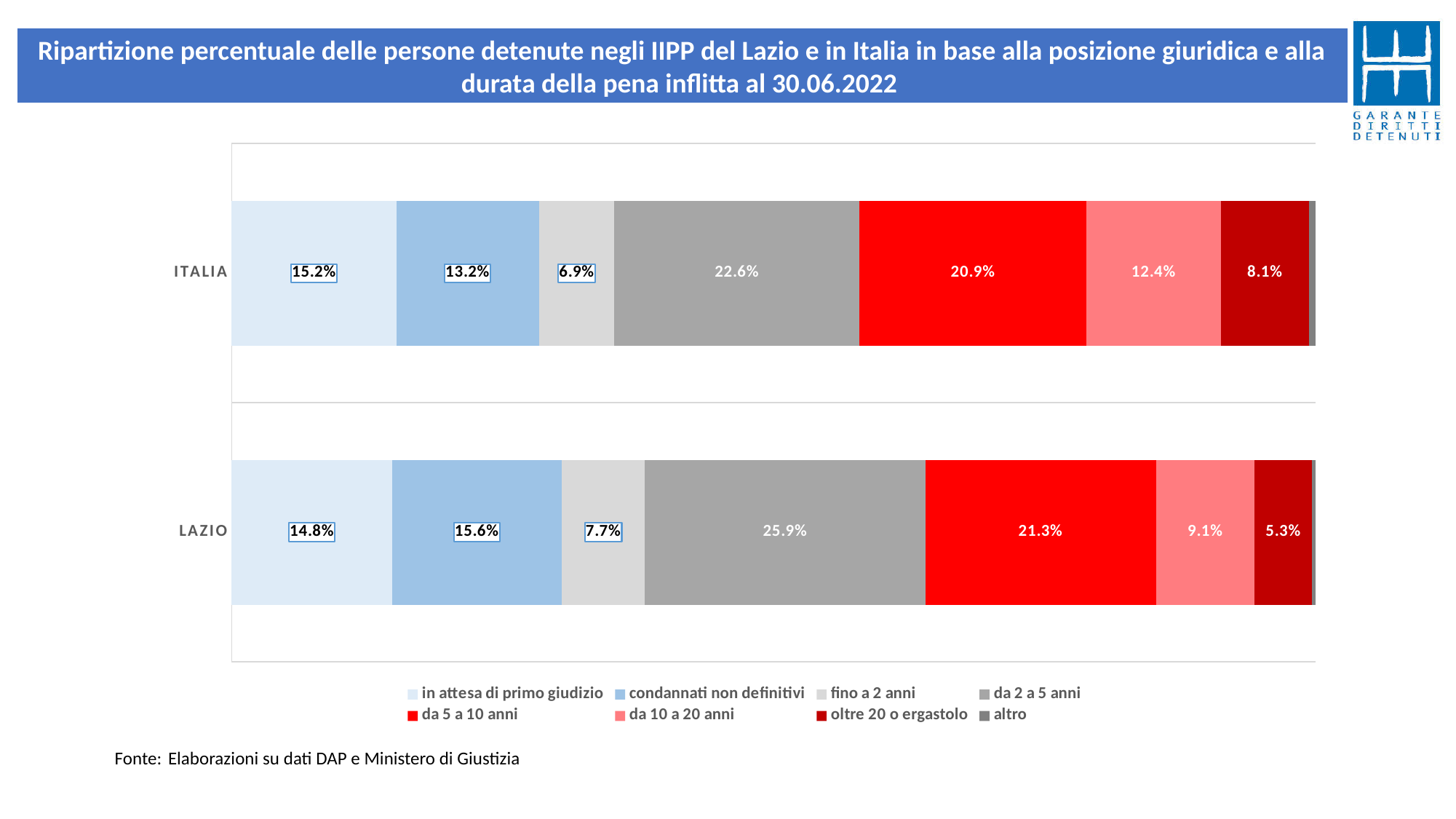
Which labelled segment is the largest in the ITALIA bar? da 2 a 5 anni What percentage of detainees in ITALIA are 'in attesa di primo giudizio'? 15.2% What is the value of the 'da 2 a 5 anni' segment for LAZIO? 25.9% How many series does the legend list? 8 How many bars (categories) are shown in the chart? 2 Which has a higher 'condannati non definitivi' share, ITALIA or LAZIO? LAZIO What type of chart is shown on the slide? Stacked bar chart What is the value of the 'da 10 a 20 anni' segment for ITALIA? 12.4% Which labelled segment is the largest in the LAZIO bar? da 2 a 5 anni Which has a higher 'da 10 a 20 anni' share, ITALIA or LAZIO? ITALIA What percentage of detainees in LAZIO fall in the 'oltre 20 o ergastolo' category? 5.3% What is the difference between the 'da 2 a 5 anni' values for LAZIO and ITALIA? 3.3%